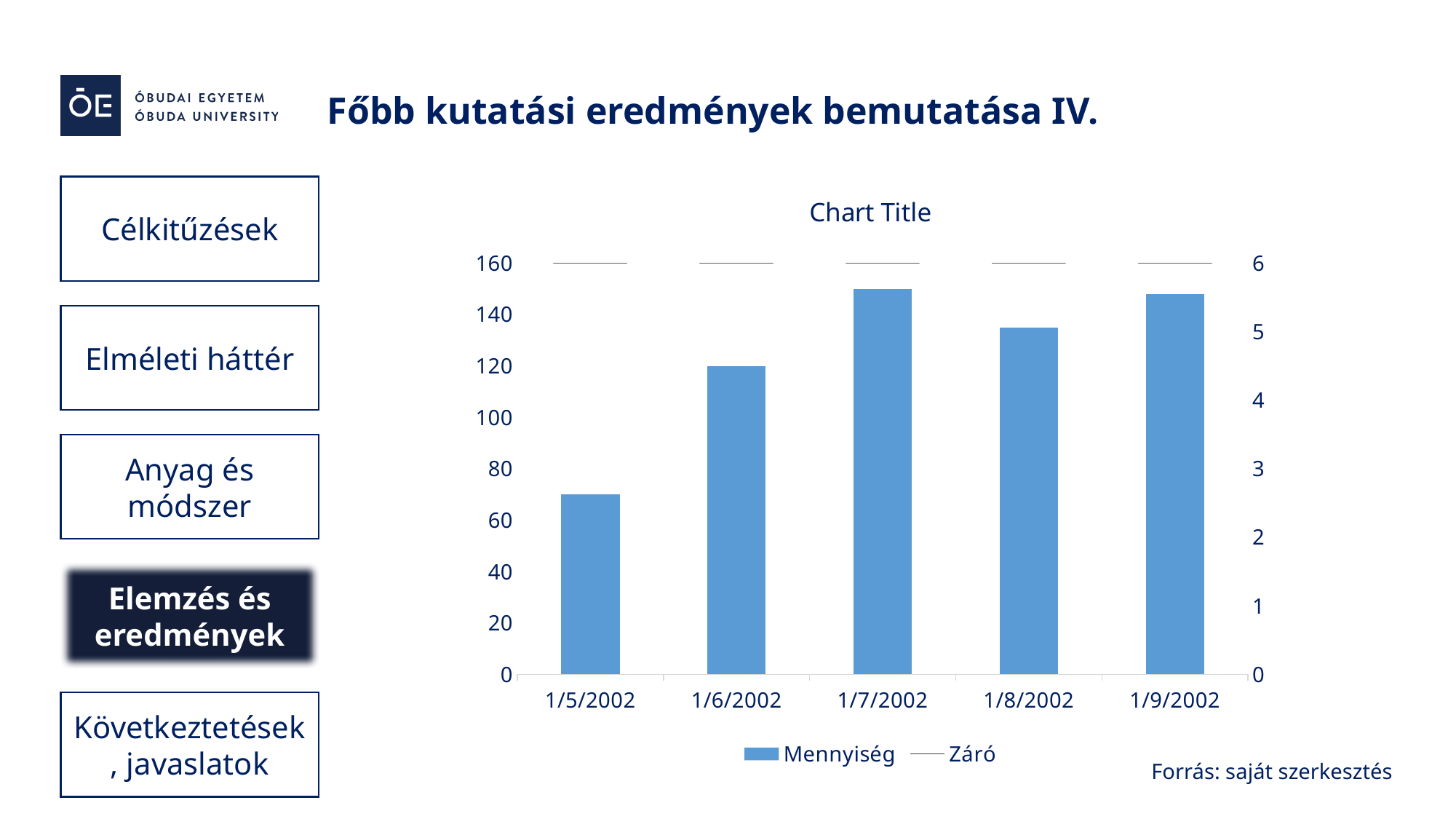
How many categories (dates) are shown on the x axis of the chart? 5 What is the title shown above the chart? Chart Title Which date has the lowest Mennyiség bar? 1/5/2002 Do the Mennyiség bars rise or fall from 1/5/2002 to 1/7/2002? rise How many series does the chart's legend list? 2 Is the Mennyiség value for 1/5/2002 greater or less than 80? less Is the Mennyiség value for 1/7/2002 greater or less than 140? greater Which has the larger Mennyiség bar, 1/6/2002 or 1/8/2002? 1/8/2002 Is the Mennyiség value for 1/9/2002 greater or less than 140? greater What kind of chart is shown on the slide? bar chart What are the two series names listed in the chart's legend? Mennyiség and Záró